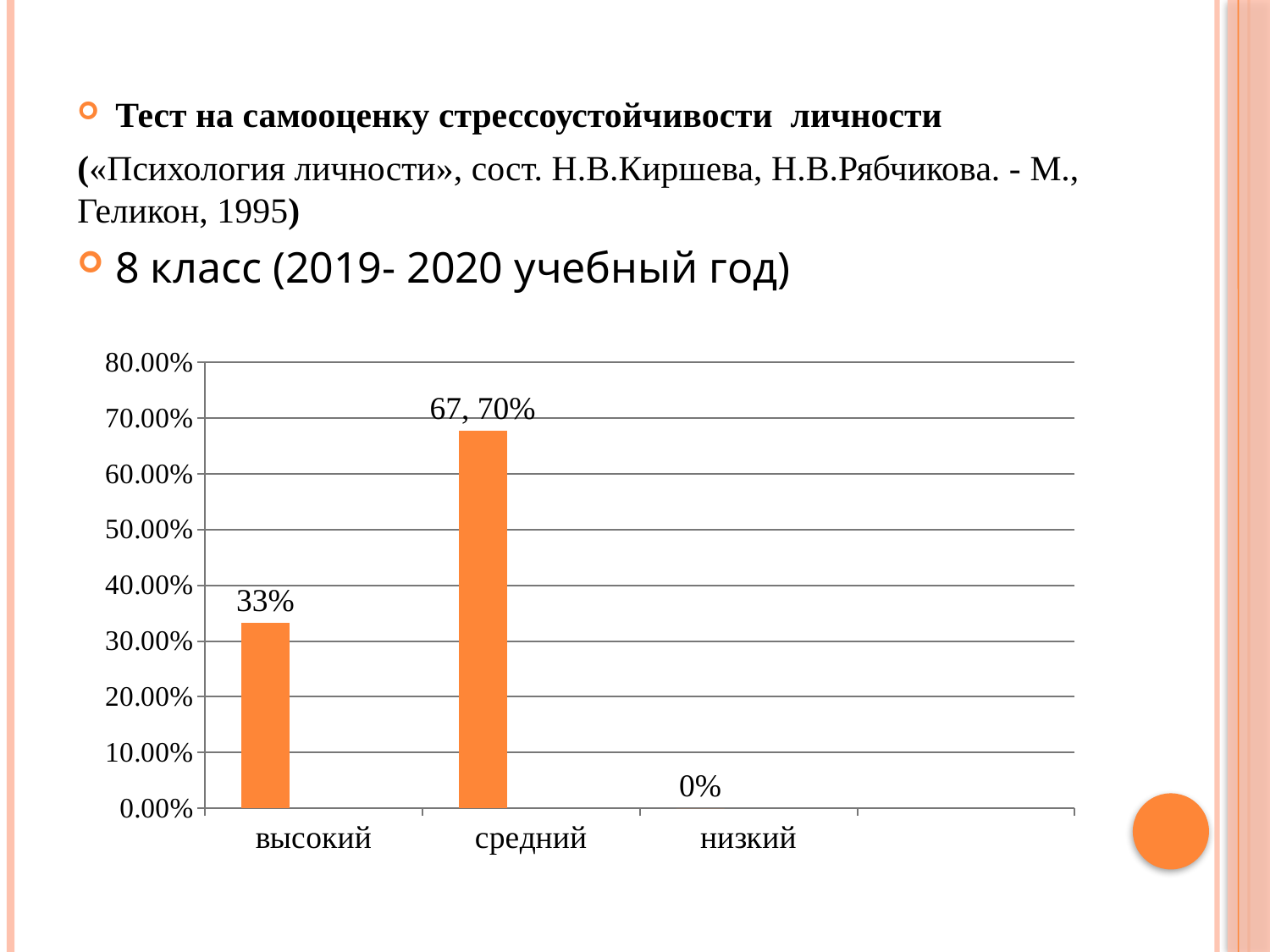
Which category has the highest value? средний What is the highest value shown on the y axis? 80.00% What value is shown for the category средний? 67, 70% What value is shown for the category высокий? 33% What colour are the bars in the chart? orange What kind of chart is shown on the slide? bar chart Is the value for высокий greater or less than 40.00%? less What value is shown for the category низкий? 0% Which category has the lowest value? низкий How many categories are shown on the x axis? 3 Which is larger, the value for высокий or the value for средний? средний Is the value for средний greater or less than 60.00%? greater